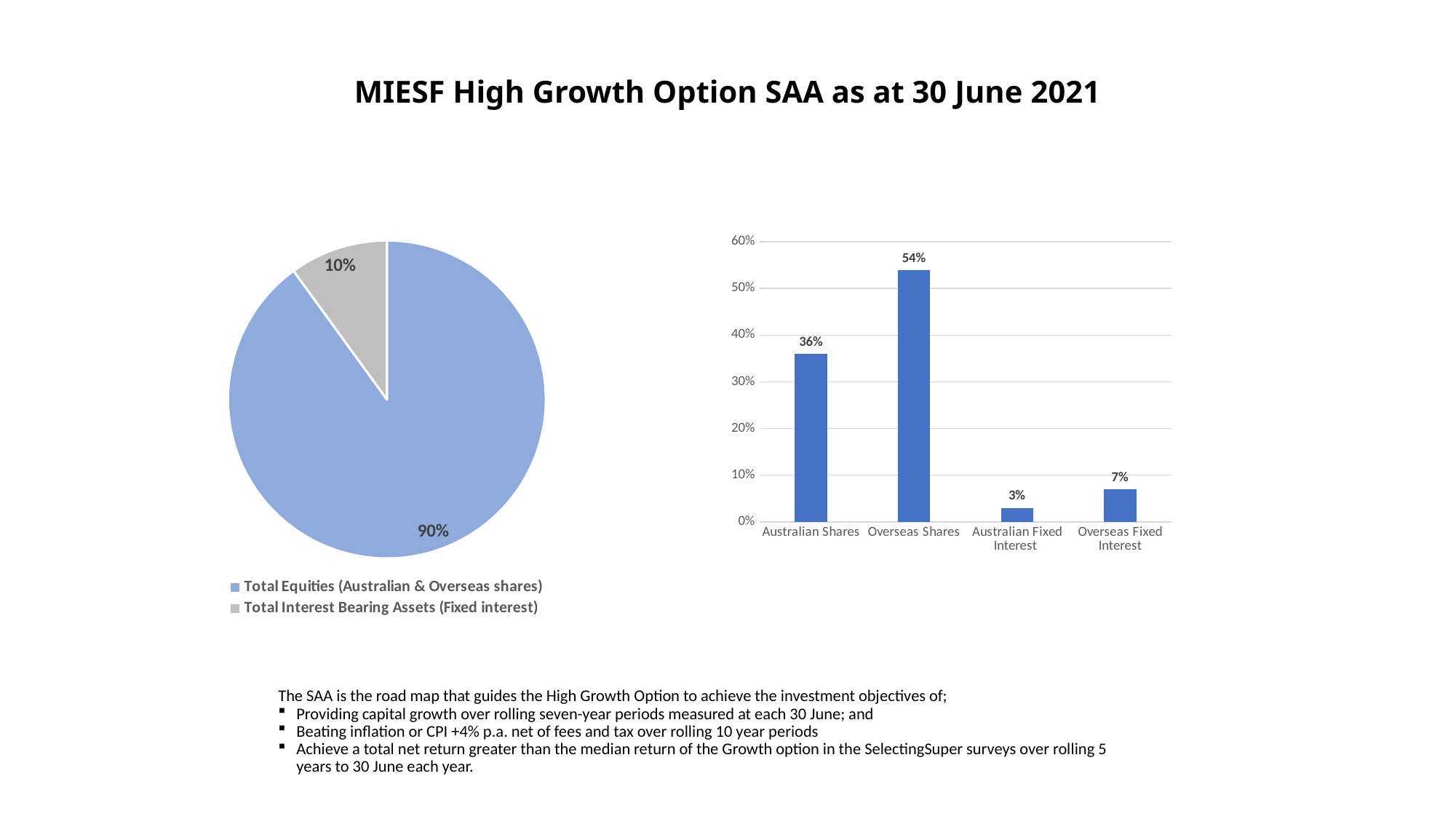
In the bar chart on the right, what is the difference between Overseas Shares and Australian Shares? 18% In the pie chart on the left, what share is Total Equities (Australian & Overseas shares)? 90% In the pie chart on the left, which slice is the largest? Total Equities (Australian & Overseas shares) In the bar chart on the right, how many categories are shown? 4 In the bar chart on the right, which category has the highest value? Overseas Shares In the bar chart on the right, what is the value for Australian Fixed Interest? 3% In the bar chart on the right, what is the value for Overseas Shares? 54% In the pie chart on the left, what share is Total Interest Bearing Assets (Fixed interest)? 10% In the bar chart on the right, which category has the lowest value? Australian Fixed Interest In the pie chart on the left, how many slices are there? 2 What kind of chart is on the right of the slide? Bar chart In the bar chart on the right, which is larger, Overseas Fixed Interest or Australian Fixed Interest? Overseas Fixed Interest